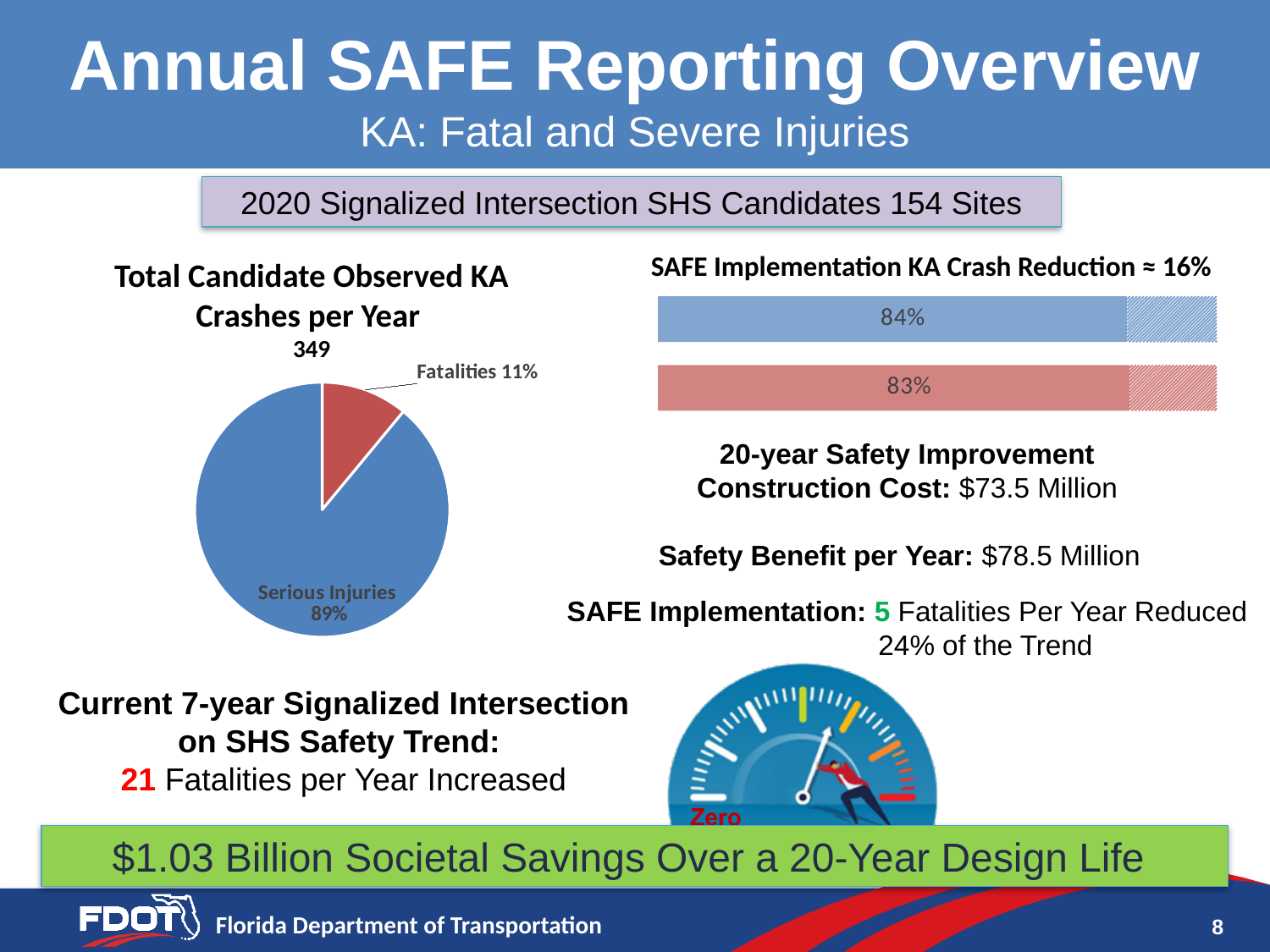
What kind of chart is the 'Total Candidate Observed KA Crashes per Year' chart? pie chart What total number is shown above the 'Total Candidate Observed KA Crashes per Year' pie chart? 349 In the 'Total Candidate Observed KA Crashes per Year' pie chart, what share is Fatalities? 11% In the 'Total Candidate Observed KA Crashes per Year' pie chart, which slice is the smallest? Fatalities In the 'SAFE Implementation KA Crash Reduction ≈ 16%' chart, what value is labeled on the bottom (red) bar? 83% What kind of chart is the 'SAFE Implementation KA Crash Reduction ≈ 16%' chart? bar chart In the 'SAFE Implementation KA Crash Reduction ≈ 16%' chart, what value is labeled on the top (blue) bar? 84% In the 'Total Candidate Observed KA Crashes per Year' pie chart, what share is Serious Injuries? 89% In the 'Total Candidate Observed KA Crashes per Year' pie chart, what is the difference in percentage points between Serious Injuries and Fatalities? 78 In the 'Total Candidate Observed KA Crashes per Year' pie chart, which slice is larger, Fatalities or Serious Injuries? Serious Injuries How many bars are in the 'SAFE Implementation KA Crash Reduction ≈ 16%' chart? 2 How many slices does the 'Total Candidate Observed KA Crashes per Year' pie chart have? 2